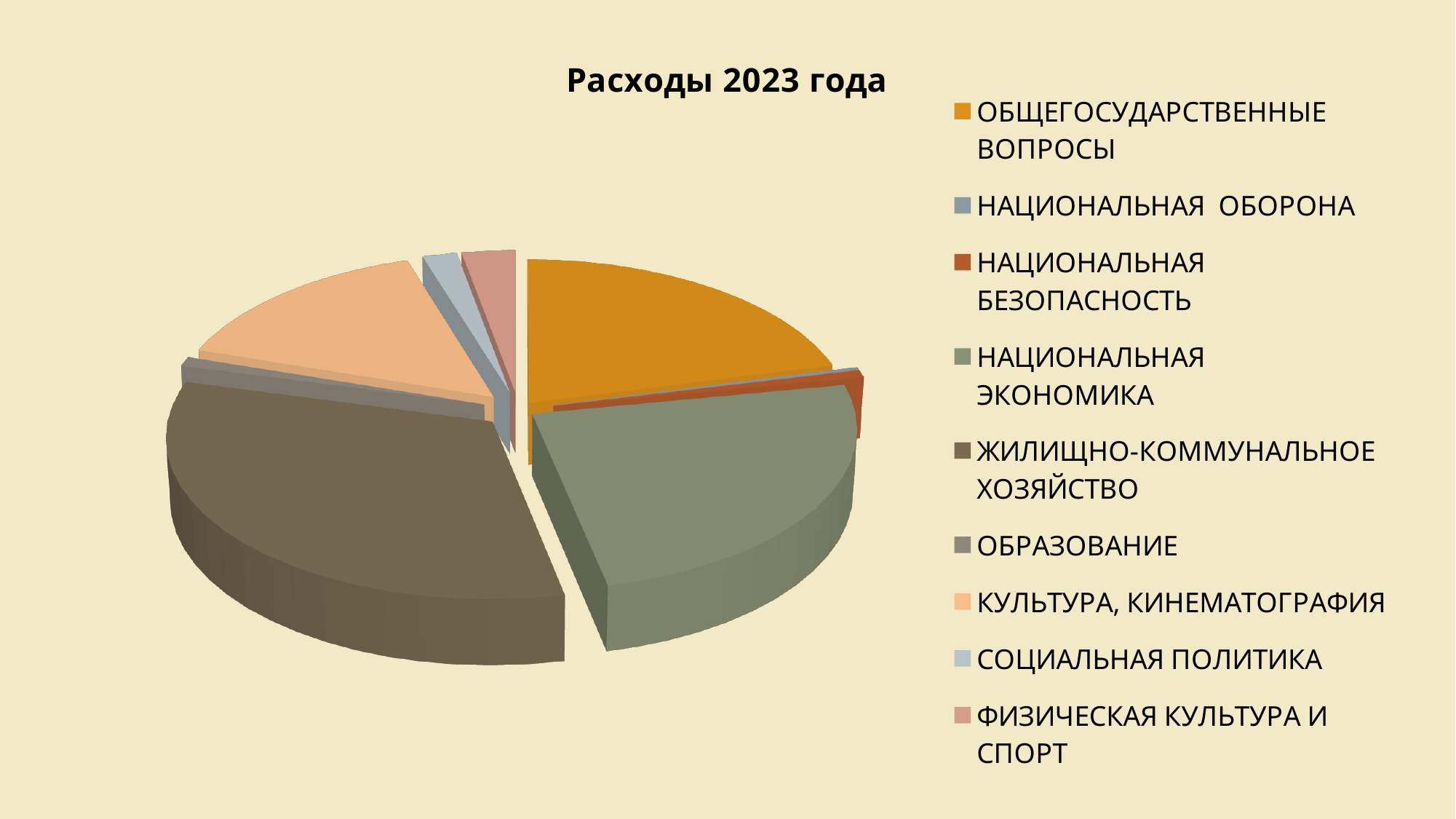
Which category has the largest slice of the pie? ЖИЛИЩНО-КОММУНАЛЬНОЕ ХОЗЯЙСТВО Which category is shown in orange in the pie chart? ОБЩЕГОСУДАРСТВЕННЫЕ ВОПРОСЫ What kind of chart is shown on the slide? pie chart Which slice is larger: КУЛЬТУРА, КИНЕМАТОГРАФИЯ or СОЦИАЛЬНАЯ ПОЛИТИКА? КУЛЬТУРА, КИНЕМАТОГРАФИЯ Which slice is larger: ЖИЛИЩНО-КОММУНАЛЬНОЕ ХОЗЯЙСТВО or ОБРАЗОВАНИЕ? ЖИЛИЩНО-КОММУНАЛЬНОЕ ХОЗЯЙСТВО What is the title of the chart? Расходы 2023 года Which slice is larger: ОБЩЕГОСУДАРСТВЕННЫЕ ВОПРОСЫ or ФИЗИЧЕСКАЯ КУЛЬТУРА И СПОРТ? ОБЩЕГОСУДАРСТВЕННЫЕ ВОПРОСЫ How many categories does the legend of the pie chart list? 9